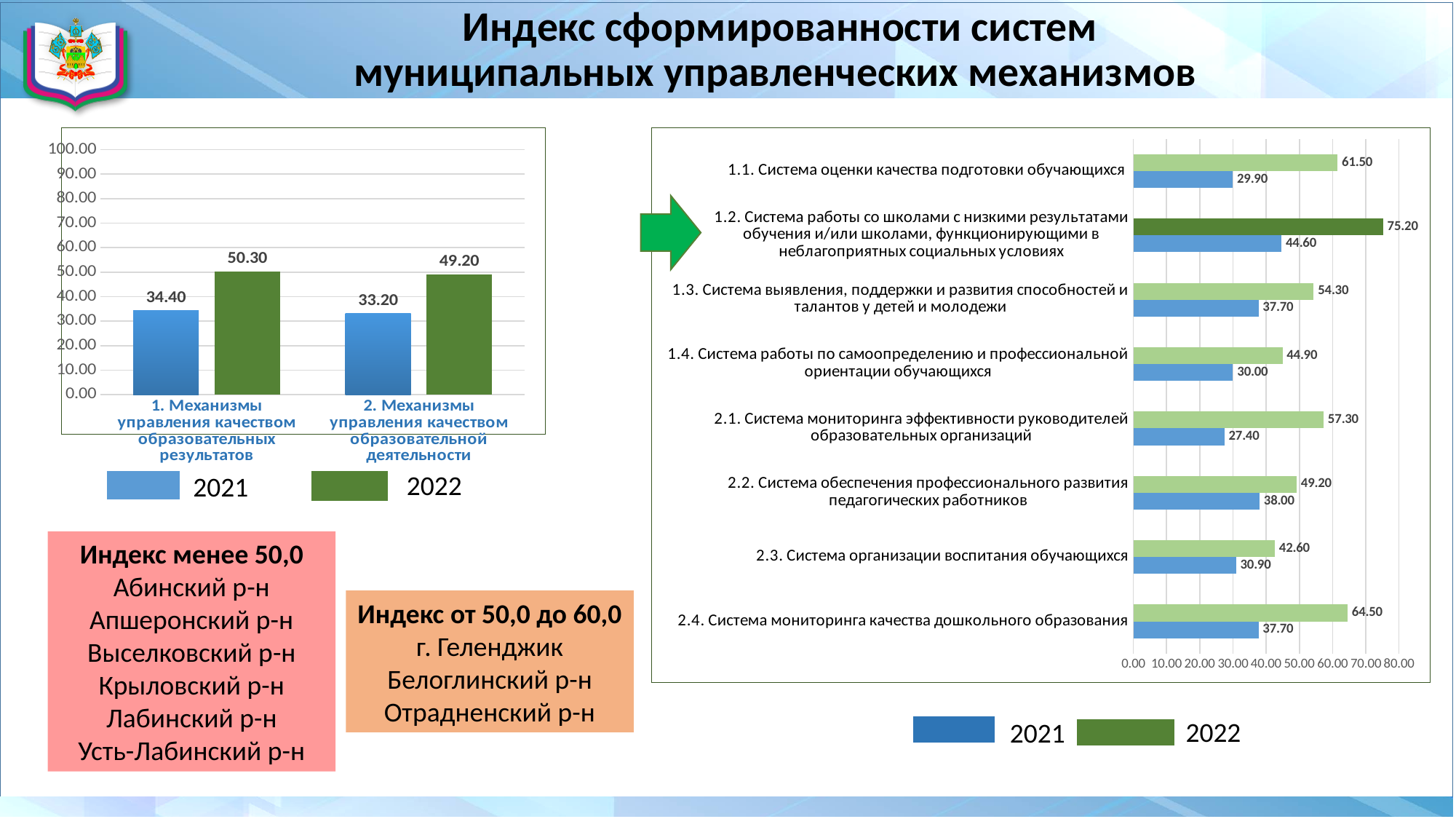
In the right chart, what is the 2021 value for "2.1. Система мониторинга эффективности руководителей образовательных организаций"? 27.40 How many series does the legend of the left chart list? 2 In the right chart, how many categories are shown? 8 In the left chart, what is the difference between the 2022 and 2021 values for "1. Механизмы управления качеством образовательных результатов"? 15.90 What kind of chart is the left chart? Bar chart In the right chart, what is the difference between the 2022 and 2021 values for "2.4. Система мониторинга качества дошкольного образования"? 26.80 In the left chart, what is the 2021 value for "2. Механизмы управления качеством образовательной деятельности"? 33.20 In the left chart, what is the 2022 value for "1. Механизмы управления качеством образовательных результатов"? 50.30 In the right chart, which is larger: the 2022 value for "2.3. Система организации воспитания обучающихся" or the 2022 value for "1.4. Система работы по самоопределению и профессиональной ориентации обучающихся"? 1.4. Система работы по самоопределению и профессиональной ориентации обучающихся In the right chart, which category has the lowest 2021 value? 2.1. Система мониторинга эффективности руководителей образовательных организаций In the right chart, what is the 2022 value for "1.2. Система работы со школами с низкими результатами обучения и/или школами, функционирующими в неблагоприятных социальных условиях"? 75.20 In the right chart, which category has the highest 2022 value? 1.2. Система работы со школами с низкими результатами обучения и/или школами, функционирующими в неблагоприятных социальных условиях